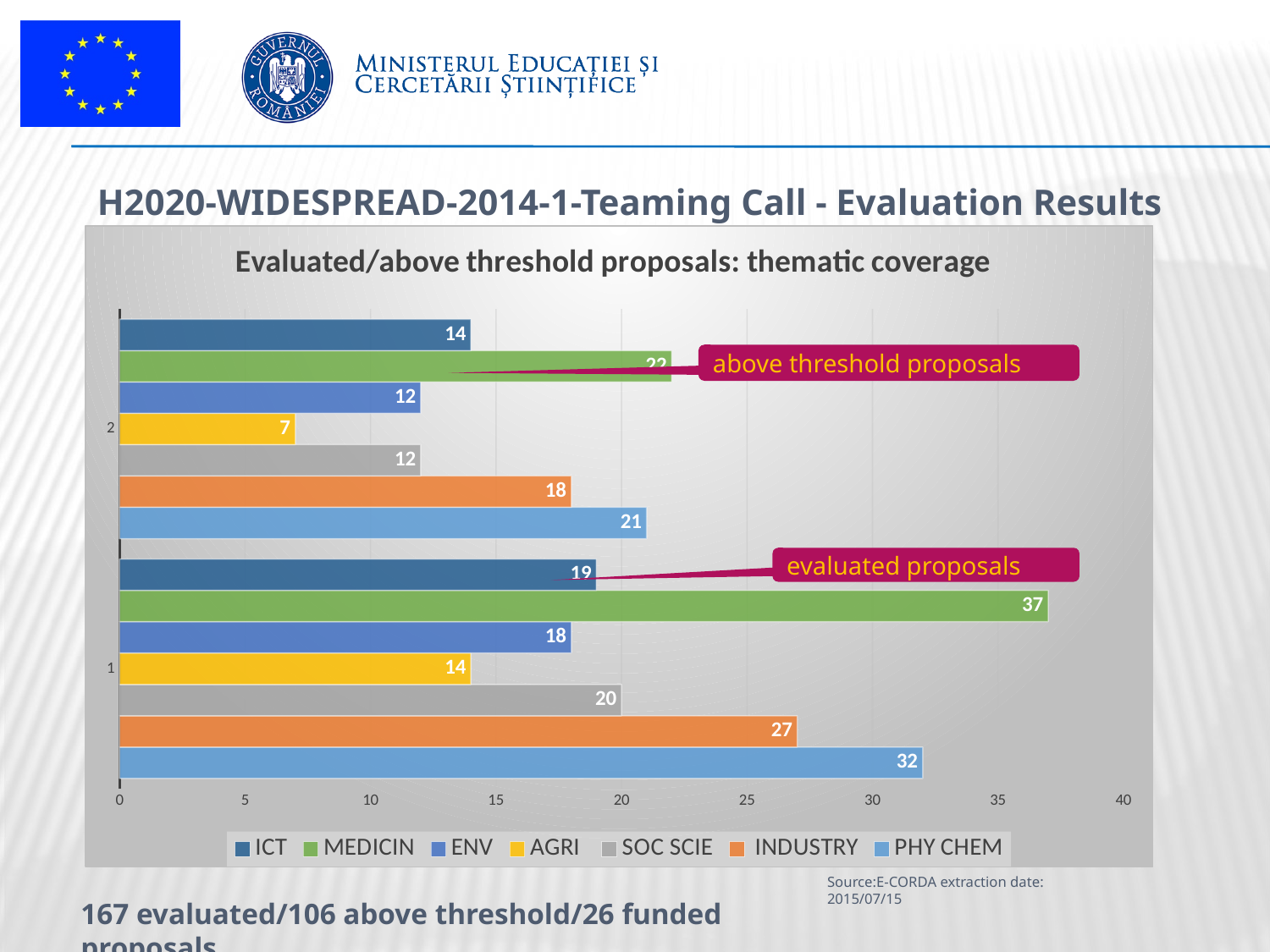
How many evaluated proposals (category 1) were there for MEDICIN? 37 How many series does the legend list? 7 Which has more evaluated proposals (category 1): ICT or ENV? ICT What is the title of the chart? Evaluated/above threshold proposals: thematic coverage What is the difference between the evaluated proposals (category 1) for INDUSTRY and for SOC SCIE? 7 How many evaluated proposals (category 1) were there for PHY CHEM? 32 Which thematic area has the highest number of evaluated proposals (category 1)? MEDICIN Is the value for PHY CHEM above threshold proposals (category 2) greater or less than 20? greater What kind of chart is shown on the slide? bar chart How many above threshold proposals (category 2) were there for INDUSTRY? 18 Which thematic area has the lowest number of above threshold proposals (category 2)? AGRI How many above threshold proposals (category 2) were there for AGRI? 7